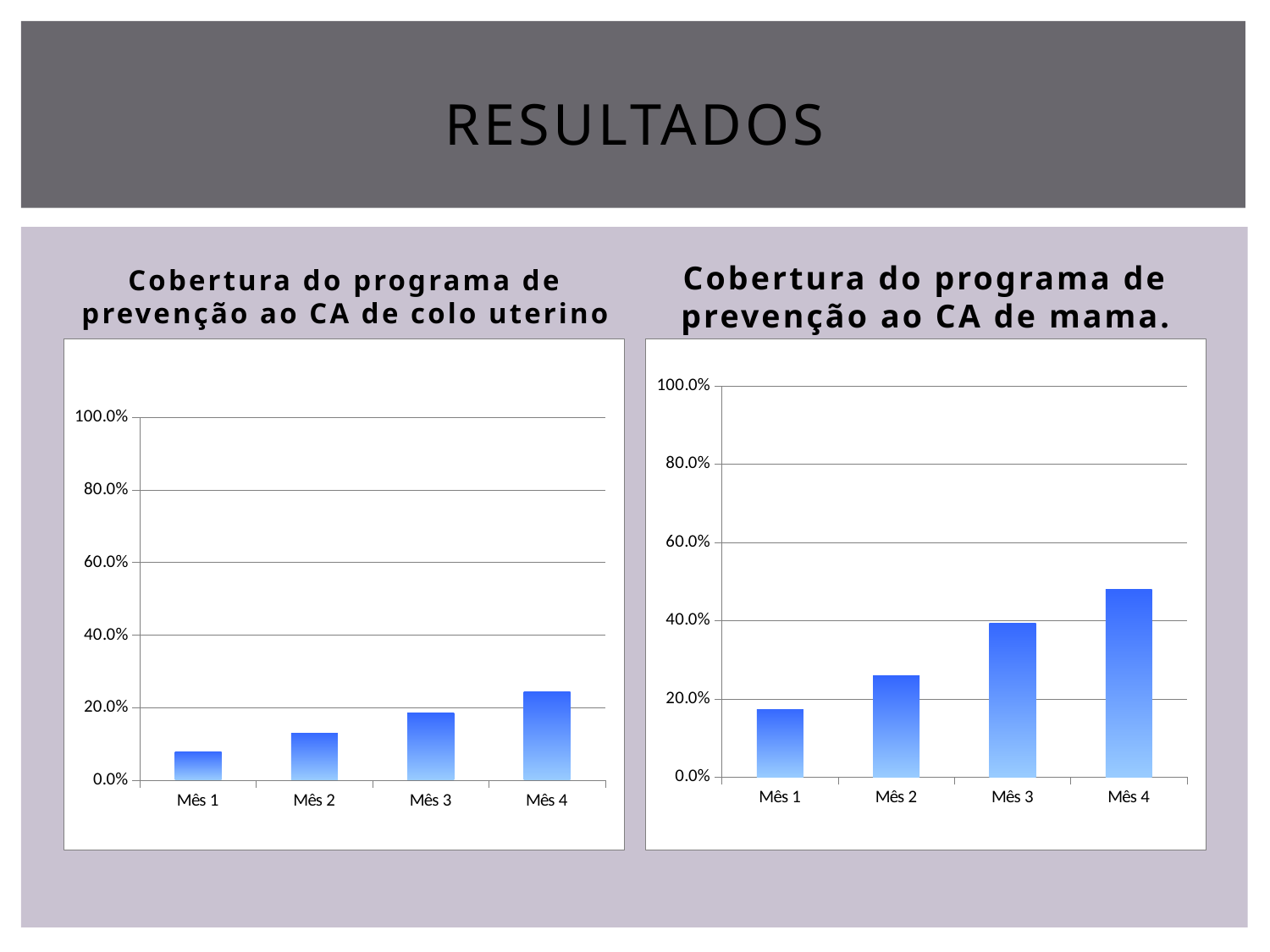
In the chart titled "Cobertura do programa de prevenção ao CA de mama.", do the values rise or fall from Mês 1 to Mês 4? rise In the right chart (CA de mama), is the value for Mês 1 greater or less than 20.0%? less In the left chart (CA de colo uterino), is the value for Mês 4 greater or less than 20.0%? greater In the left chart (CA de colo uterino), is the value for Mês 1 greater or less than 20.0%? less In the chart titled "Cobertura do programa de prevenção ao CA de colo uterino", which month has the highest value? Mês 4 In the chart titled "Cobertura do programa de prevenção ao CA de mama.", which month has the lowest value? Mês 1 In the chart titled "Cobertura do programa de prevenção ao CA de colo uterino", which month has the lowest value? Mês 1 How many months are shown on the x axis of the chart titled "Cobertura do programa de prevenção ao CA de colo uterino"? 4 In the chart titled "Cobertura do programa de prevenção ao CA de mama.", which month has the highest value? Mês 4 What kind of chart is the chart titled "Cobertura do programa de prevenção ao CA de mama."? bar chart